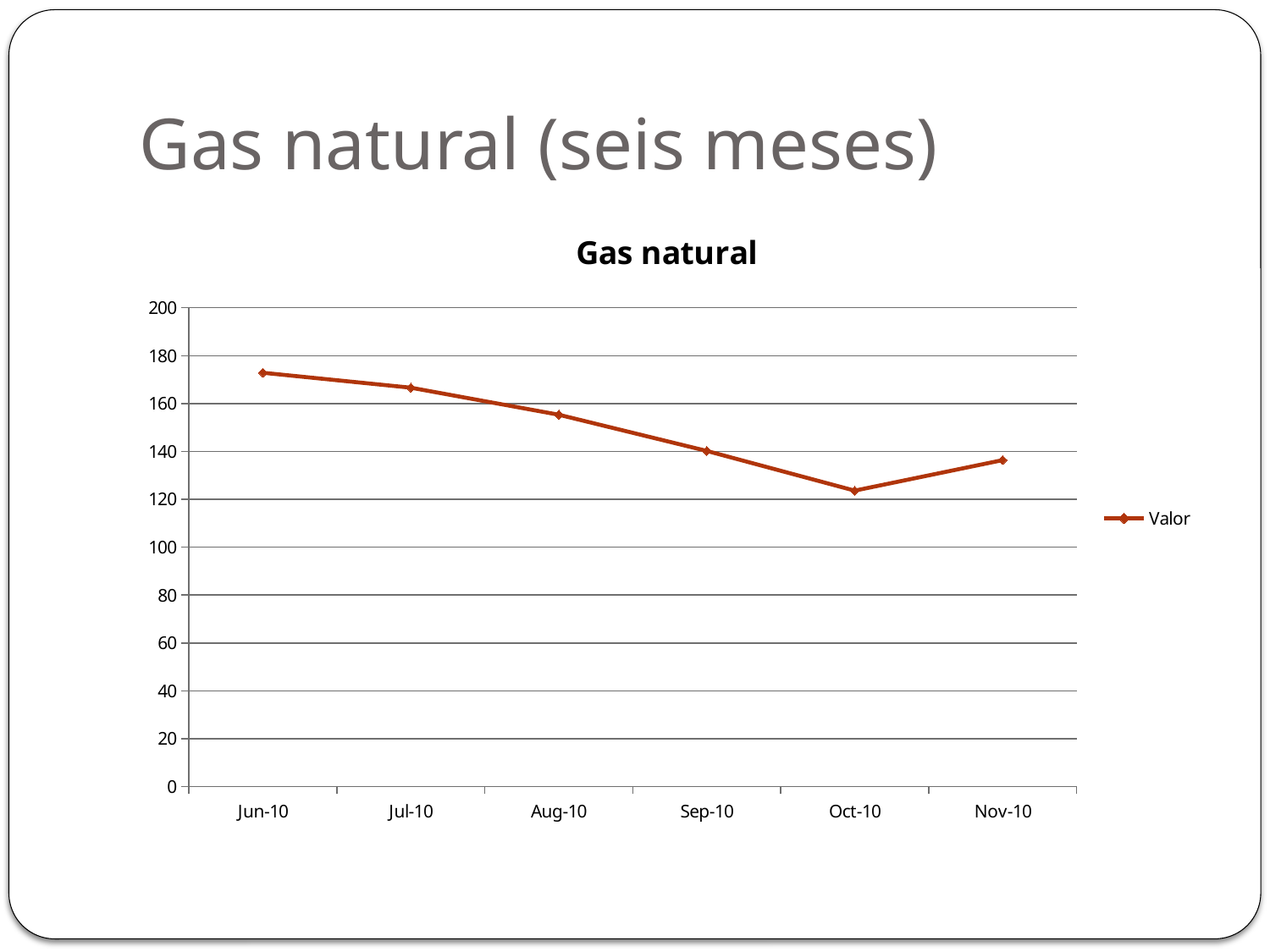
How many months are plotted on the x axis? 6 Which month has the lowest value? Oct-10 Do the values rise or fall from Jun-10 to Oct-10? fall Which month has the highest value? Jun-10 What is the name of the series shown in the legend? Valor Is the value for Oct-10 greater or less than 140? less Is the value for Jun-10 greater or less than 160? greater Is the value for Aug-10 greater or less than 140? greater What is the title of the chart? Gas natural How many series does the legend list? 1 What kind of chart is shown on the slide? line chart Which is larger, the value for Jul-10 or the value for Nov-10? Jul-10